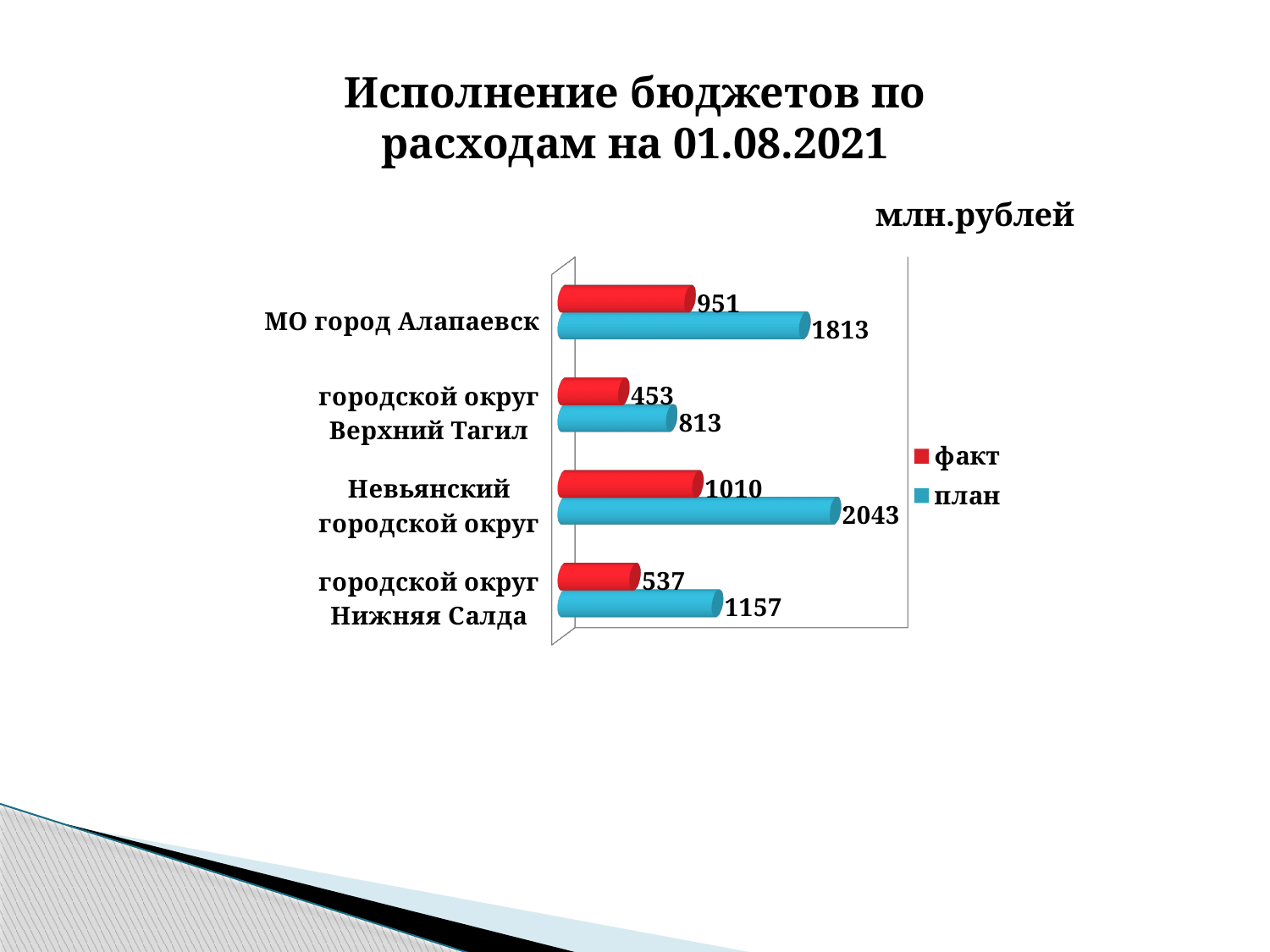
Which is larger: the факт value for Невьянский городской округ or the факт value for МО город Алапаевск? Невьянский городской округ Which category has the lowest факт value? городской округ Верхний Тагил What is the план value for городской округ Верхний Тагил? 813 How many categories are shown in the chart? 4 What is the план value for Невьянский городской округ? 2043 What kind of chart is shown on the slide? Bar chart Which category has the highest план value? Невьянский городской округ How many series does the legend list? 2 What is the difference between план and факт for МО город Алапаевск? 862 What is the факт value for городской округ Нижняя Салда? 537 What is the факт value for МО город Алапаевск? 951 What is the difference between план and факт for городской округ Нижняя Салда? 620